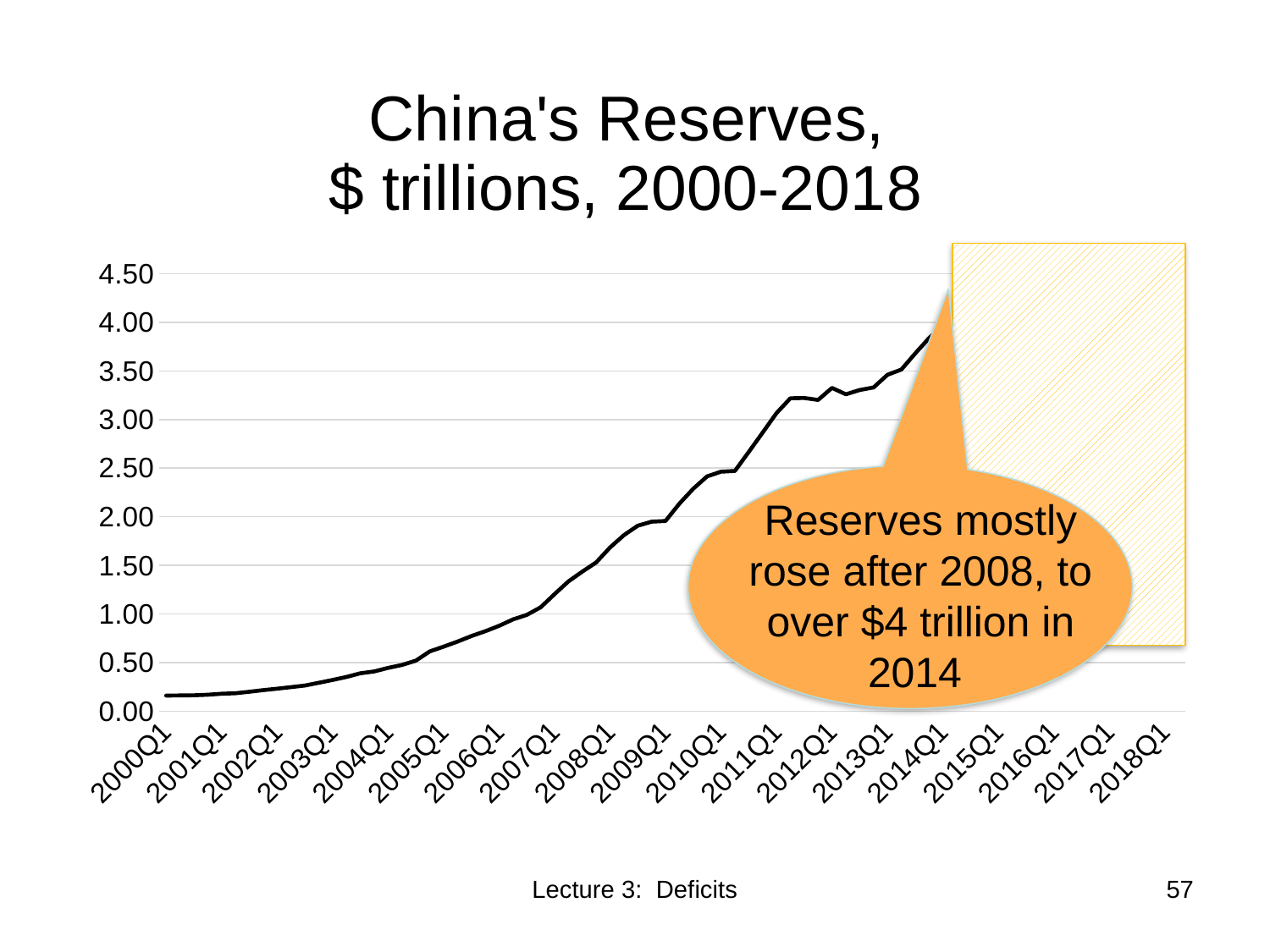
Which is larger, the value for 2008Q1 or the value for 2012Q1? 2012Q1 Do China's reserves generally rise or fall from 2000Q1 to 2014Q1? rise What does the callout on the chart say? Reserves mostly rose after 2008, to over $4 trillion in 2014 How many year labels (2000Q1 through 2018Q1) are shown on the x axis? 19 What kind of chart is shown on the slide? line chart Is the value for 2006Q1 greater or less than 0.50? greater Is the value for 2010Q1 greater or less than 2.00? greater Is the value for 2013Q1 greater or less than 4.00? less What is the title of the chart? China's Reserves, $ trillions, 2000-2018